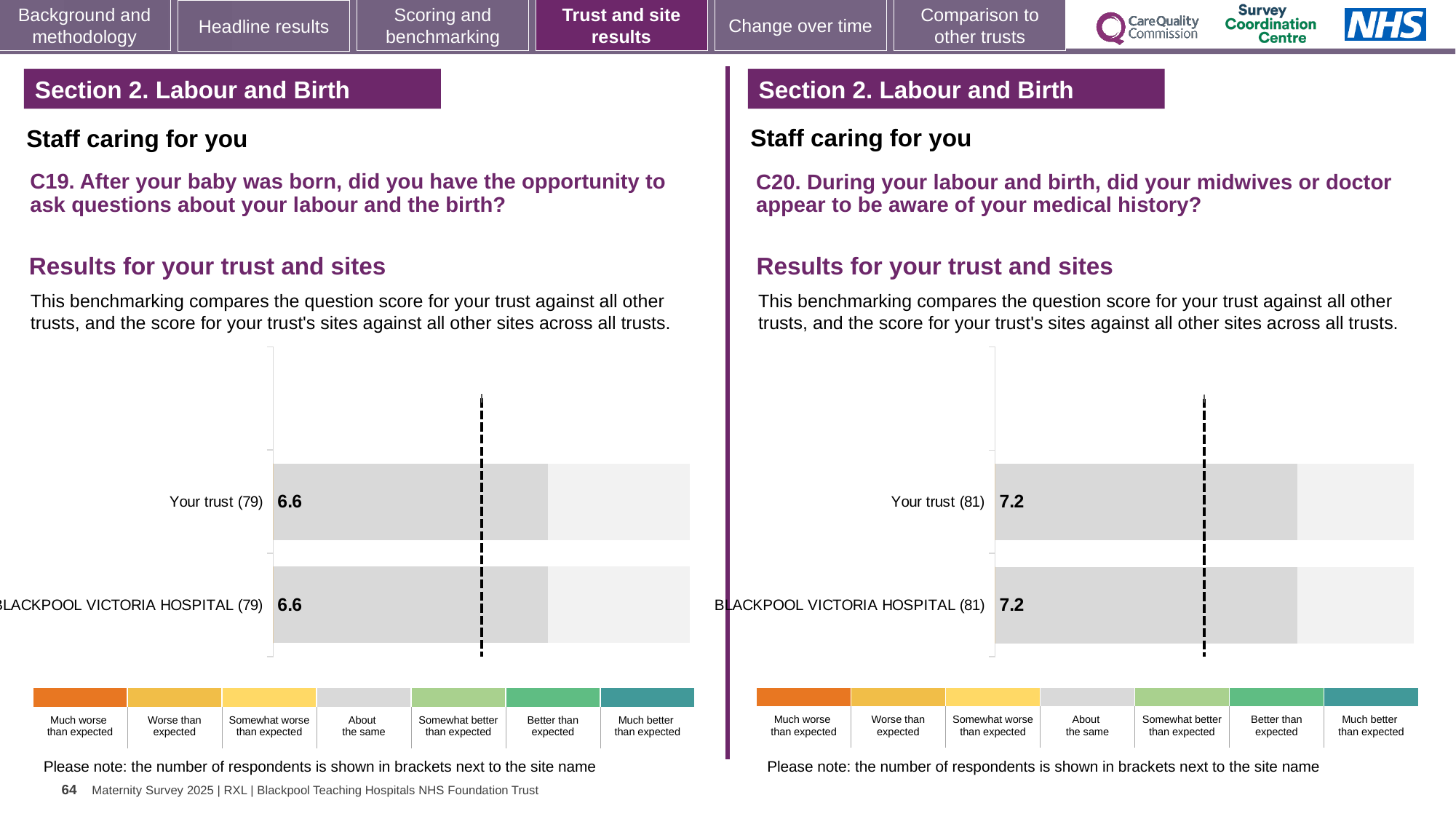
In the C19 chart on the left, what is the difference between the Your trust score and the BLACKPOOL VICTORIA HOSPITAL score? 0 What is the difference between the Your trust score in the C20 chart on the right and the Your trust score in the C19 chart on the left? 0.6 In the C19 chart on the left, what is the score for BLACKPOOL VICTORIA HOSPITAL? 6.6 In the C20 chart on the right, how many respondents are shown in brackets next to BLACKPOOL VICTORIA HOSPITAL? 81 In the C19 chart on the left, what is the score for Your trust? 6.6 In the C20 chart on the right, what is the score for BLACKPOOL VICTORIA HOSPITAL? 7.2 In the C20 chart on the right, what is the score for Your trust? 7.2 In the C20 chart on the right, how many bars are plotted? 2 What type of chart is used in the C19 chart on the left? Bar chart Which is larger: the Your trust score in the C19 chart on the left or the Your trust score in the C20 chart on the right? C20 chart on the right In the C19 chart on the left, how many respondents are shown in brackets next to Your trust? 79